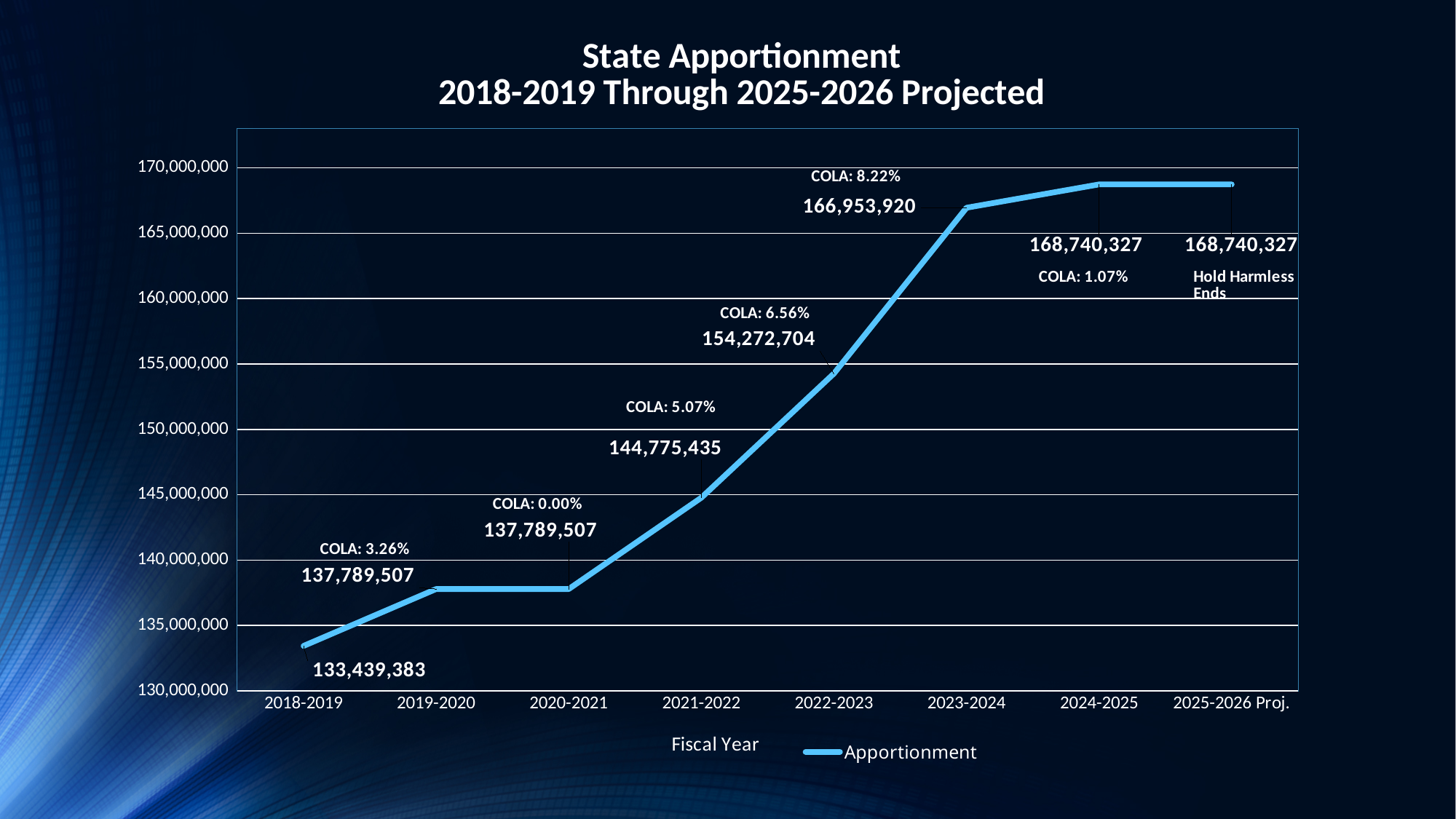
What is the difference between the apportionment for 2023-2024 and 2022-2023? 12,681,216 What is the apportionment value for 2023-2024? 166,953,920 What is the difference between the apportionment for 2019-2020 and 2018-2019? 4,350,124 Which is larger, the apportionment for 2021-2022 or for 2020-2021? 2021-2022 What kind of chart is shown on the slide? line chart What is the apportionment value for 2018-2019? 133,439,383 Is the apportionment value for 2022-2023 greater or less than 150,000,000? greater What is the apportionment value for 2022-2023? 154,272,704 How many fiscal years are plotted on the x axis? 8 What COLA percentage is annotated for 2021-2022? 5.07% Which fiscal year has the lowest apportionment? 2018-2019 How many series does the legend list? 1